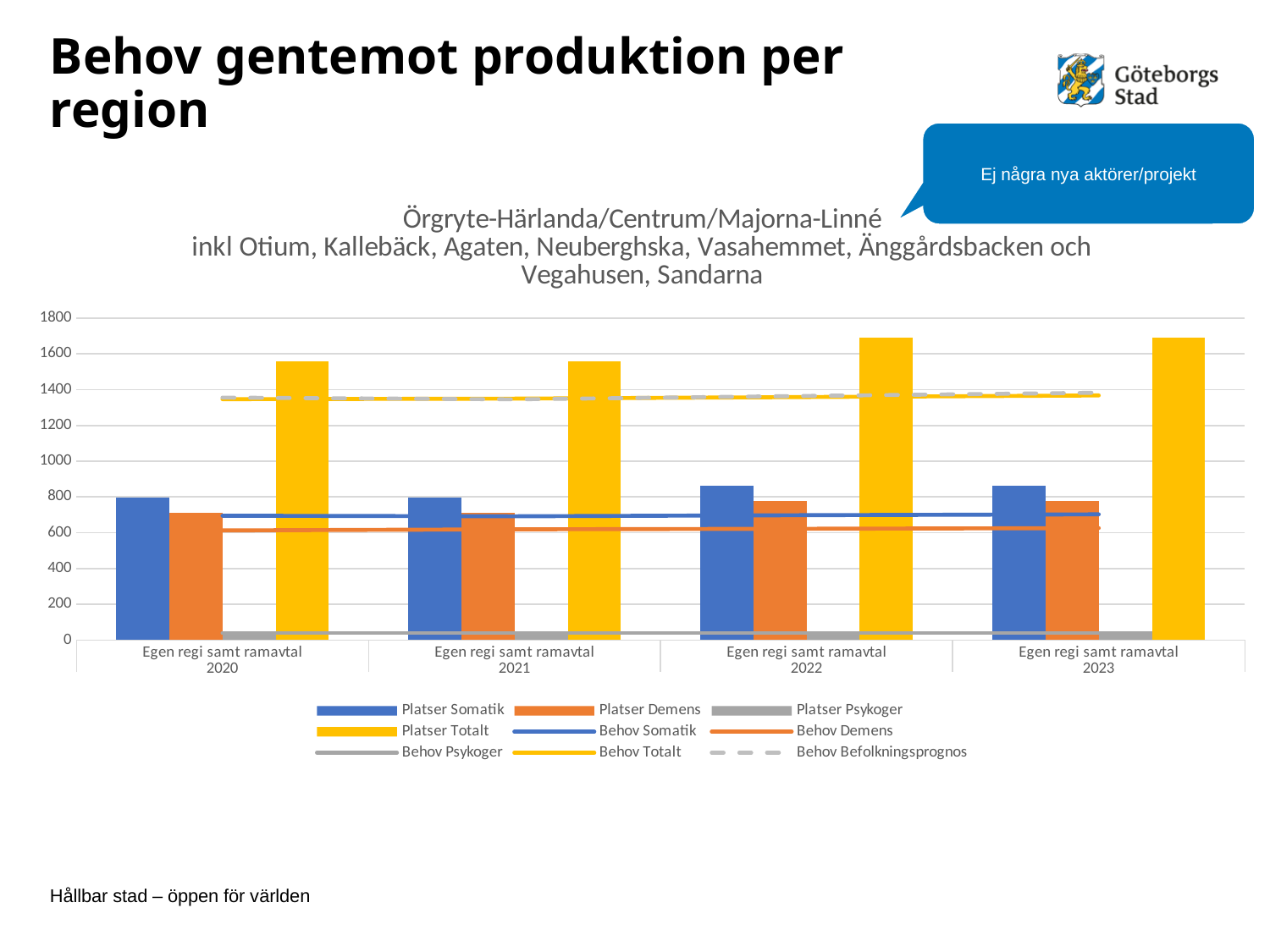
Which series is drawn as a dashed line in the legend? Behov Befolkningsprognos Is the value of Platser Totalt for 2020 greater or less than 1400? greater What kind of chart is shown on the slide? A combined bar and line chart How many series does the legend list? 9 Do the Platser Totalt bars rise or fall from 2020 to 2023? rise Is the value of Platser Demens for 2020 greater or less than 800? less In 2020, which is larger, Platser Somatik or Platser Demens? Platser Somatik Is the value of Platser Psykoger for 2021 greater or less than 200? less How many year categories are shown on the x axis? 4 Which is larger, Platser Totalt for 2022 or Platser Totalt for 2020? 2022